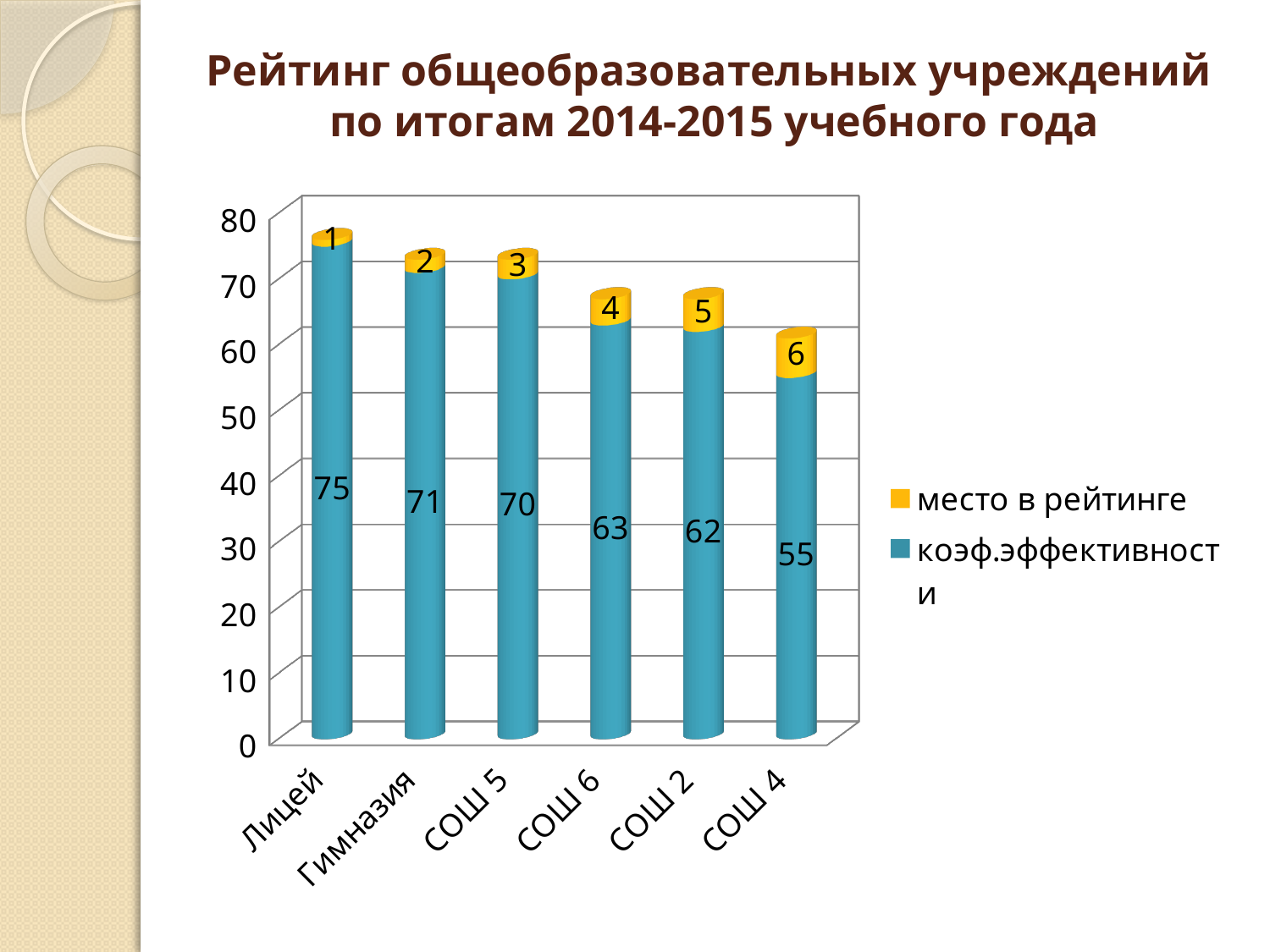
How many series does the legend list? 2 What is the total of the stacked bar for СОШ 5? 73 Do the коэф.эффективности values rise or fall from Лицей to СОШ 4 along the x axis? Fall What kind of chart is shown on the slide? Bar chart What is the коэф.эффективности value for СОШ 4? 55 How many categories are shown on the x axis? 6 Which has a larger коэф.эффективности value, Гимназия or СОШ 2? Гимназия What is the difference between the коэф.эффективности values for Лицей and СОШ 4? 20 Which category has the lowest коэф.эффективности value? СОШ 4 What is the коэф.эффективности value for Лицей? 75 What is the место в рейтинге value for СОШ 6? 4 Which category has the highest коэф.эффективности value? Лицей